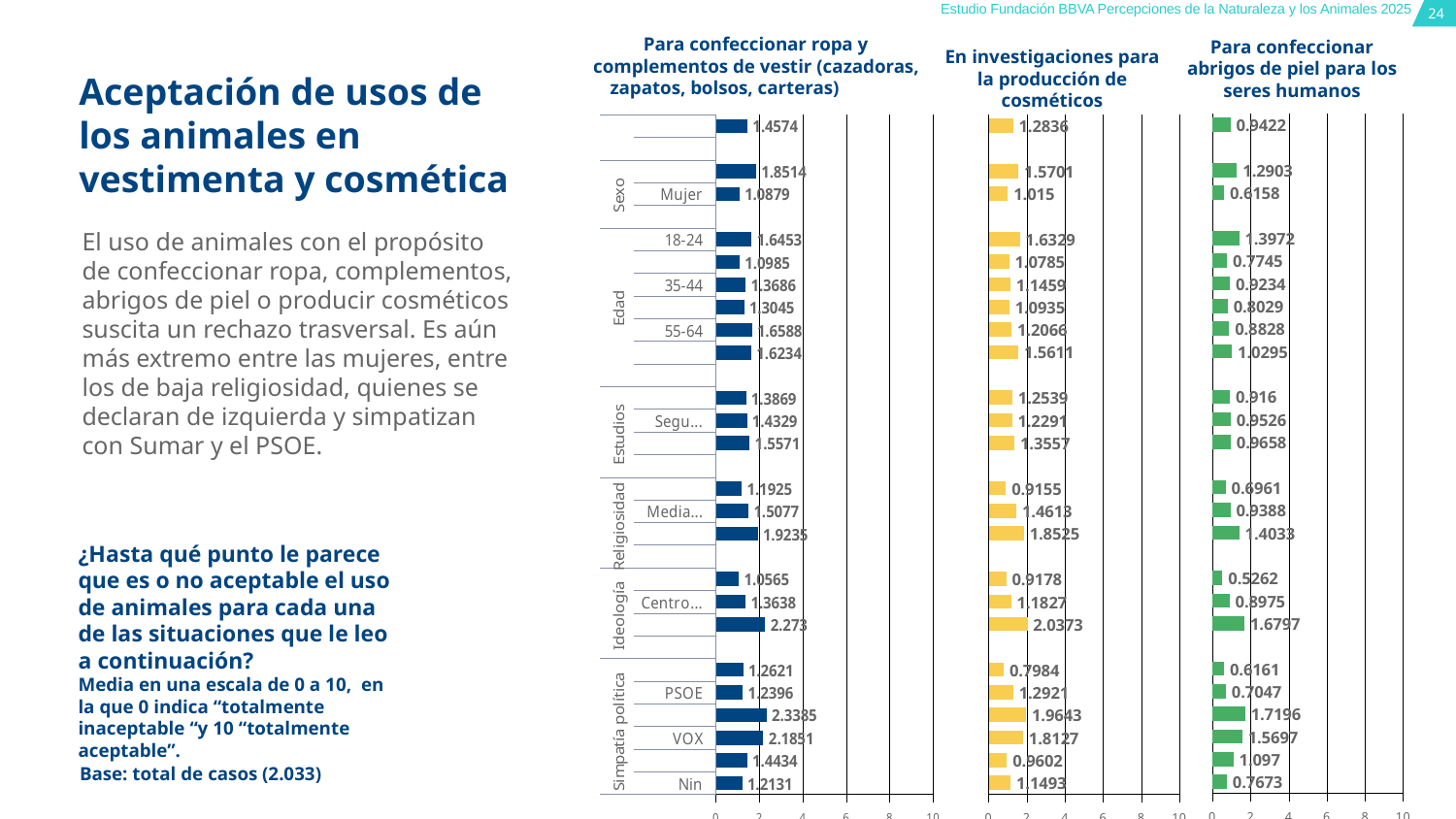
What kind of chart is used on this slide? Bar chart How many charts are shown on the slide? 3 In the chart titled 'En investigaciones para la producción de cosméticos', what is the value for 18-24? 1.6329 In the chart titled 'Para confeccionar ropa y complementos de vestir', what is the value for Mujer? 1.0879 In the chart titled 'Para confeccionar abrigos de piel para los seres humanos', what is the difference between the values for VOX and PSOE? 0.865 In the chart titled 'Para confeccionar ropa y complementos de vestir', is the value for VOX greater or less than 4? less In the chart titled 'Para confeccionar abrigos de piel para los seres humanos', which of the age groups 18-24, 35-44 and 55-64 has the highest value? 18-24 In the chart titled 'Para confeccionar abrigos de piel para los seres humanos', what is the value for VOX? 1.5697 In the chart titled 'En investigaciones para la producción de cosméticos', which is larger, the value for VOX or the value for Nin? VOX In the chart titled 'Para confeccionar ropa y complementos de vestir', what is the difference between the values for VOX and PSOE? 0.9455 In the chart titled 'Para confeccionar ropa y complementos de vestir', what is the value for PSOE? 1.2396 In the chart titled 'Para confeccionar abrigos de piel para los seres humanos', what is the value for Mujer? 0.6158